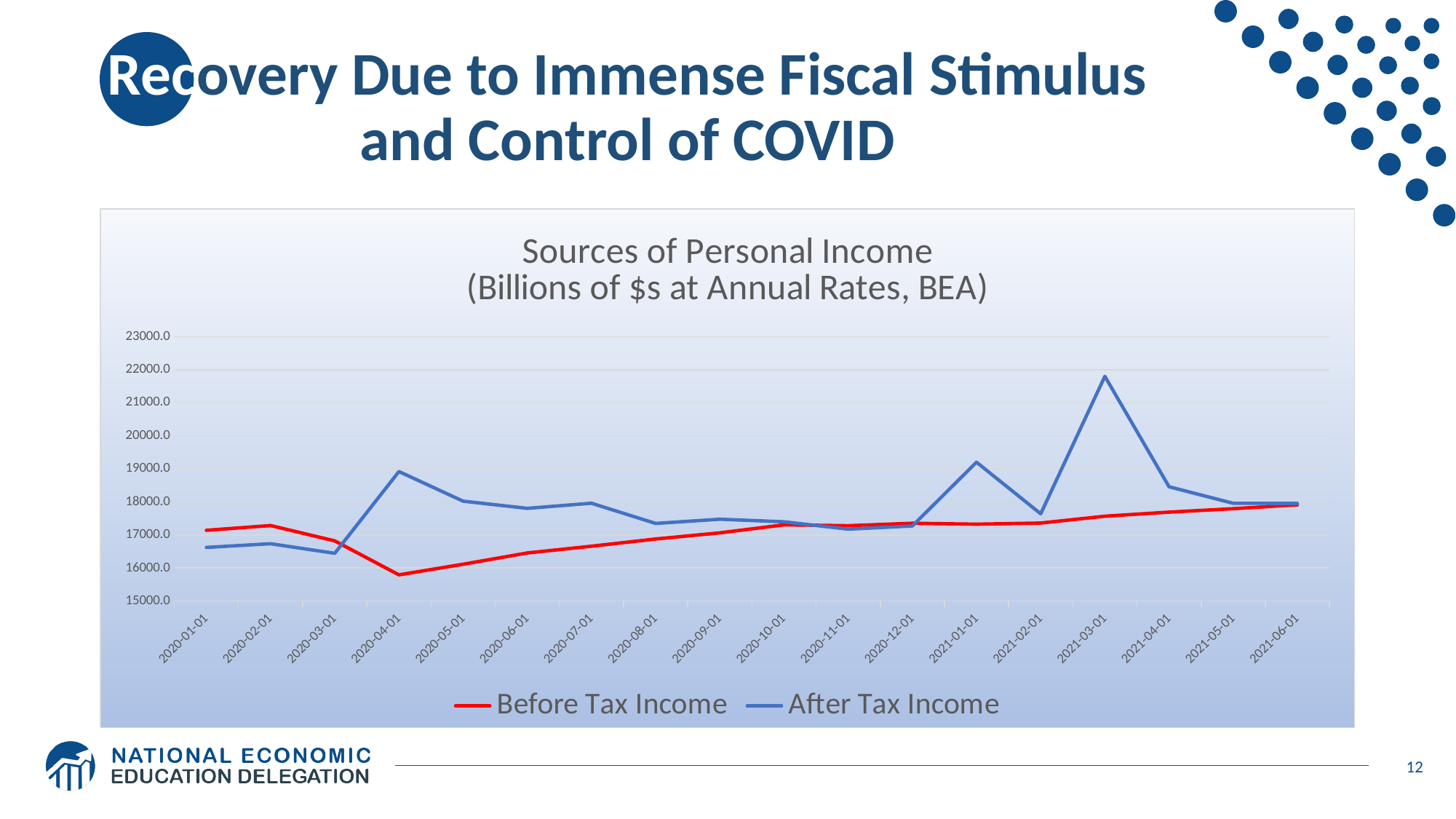
How many series does the legend list? 2 At which date does Before Tax Income reach its lowest value? 2020-04-01 Is the value for After Tax Income at 2021-03-01 greater or less than 21000.0? greater At which date does After Tax Income reach its highest value? 2021-03-01 What colour is the line for After Tax Income? blue Is the value for Before Tax Income at 2020-04-01 greater or less than 16000.0? less How many dates are shown along the x axis? 18 Does Before Tax Income rise or fall from 2020-04-01 to 2021-06-01? rise At 2020-04-01, which series has the higher value, Before Tax Income or After Tax Income? After Tax Income Is the value for After Tax Income at 2020-04-01 greater or less than 18000.0? greater At 2020-01-01, which series has the higher value, Before Tax Income or After Tax Income? Before Tax Income What kind of chart is shown on the slide? line chart